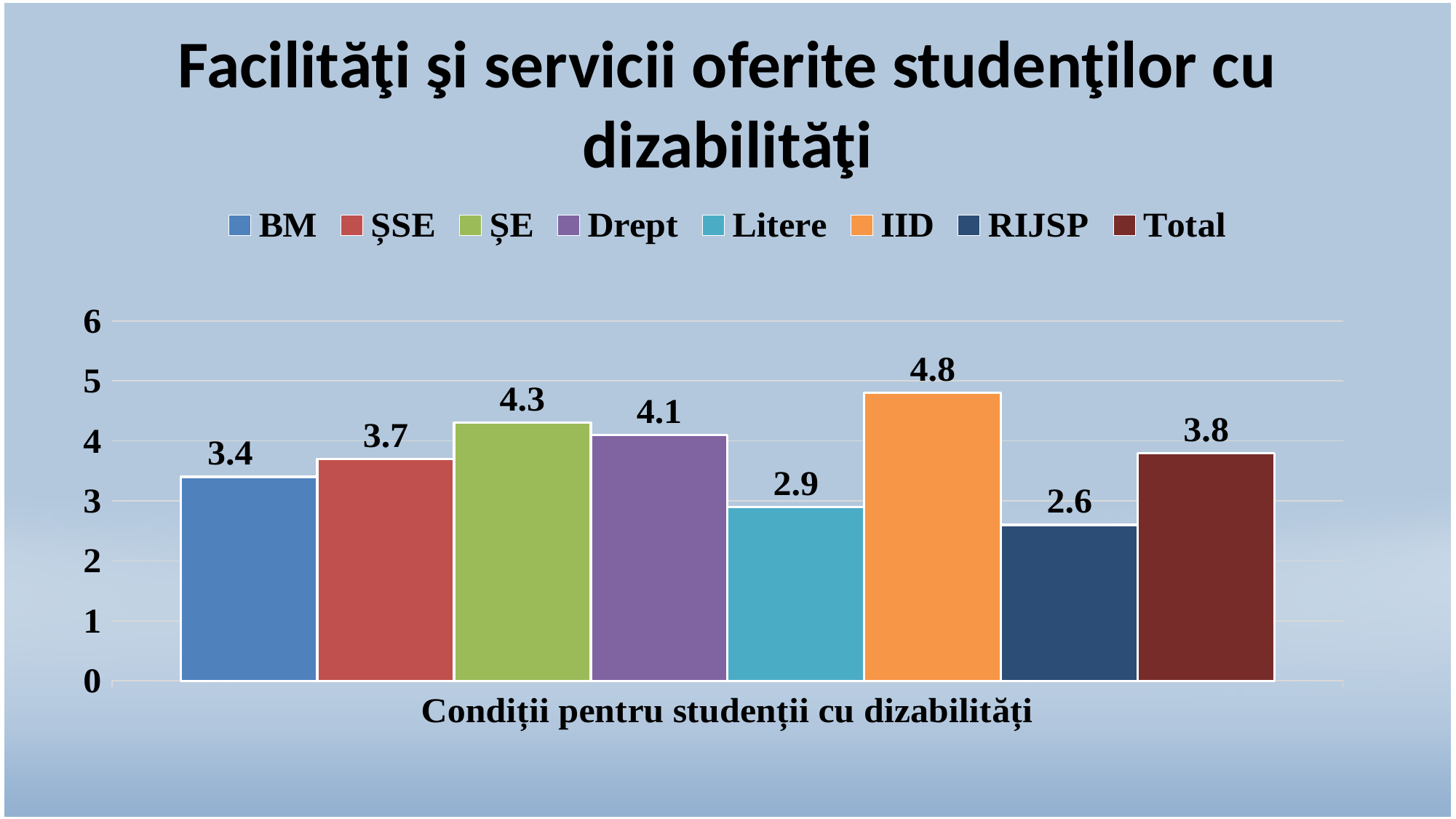
Which is larger, the value for ŞSE or the value for Litere? ŞSE What is the value for Litere? 2.9 What is the value for Total? 3.8 What is the difference between the values for Drept and BM? 0.7 What is the difference between the values for IID and RIJSP? 2.2 Which series has the highest value? IID What is the value for ŞE? 4.3 How many series does the legend list? 8 What is the label on the x axis? Condiţii pentru studenţii cu dizabilităţi What is the title of the chart? Facilităţi şi servicii oferite studenţilor cu dizabilităţi What kind of chart is shown on the slide? bar chart Which series has the lowest value? RIJSP